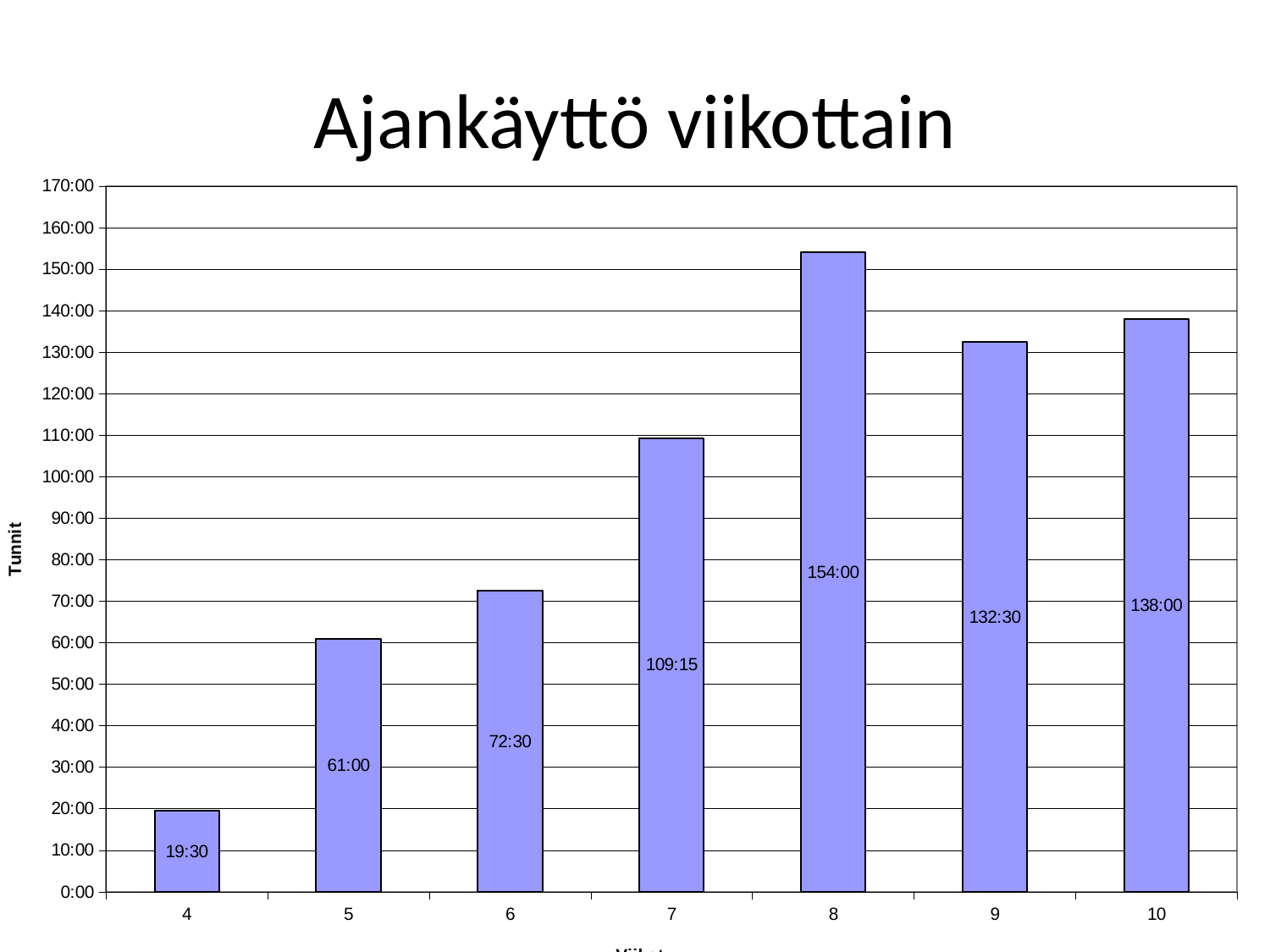
What is the title of the chart? Ajankäyttö viikottain What is the value for week 7? 109:15 How many weeks are shown on the x axis? 7 What is the value for week 9? 132:30 Is the value for week 6 greater or less than 80:00? less Which week has the lowest value? 4 Which week has the highest value? 8 What kind of chart is shown on the slide? bar chart What is the difference between the values for week 8 and week 9? 21:30 What is the difference between the values for week 5 and week 4? 41:30 Which is larger, the value for week 10 or the value for week 9? week 10 What is the value for week 4? 19:30